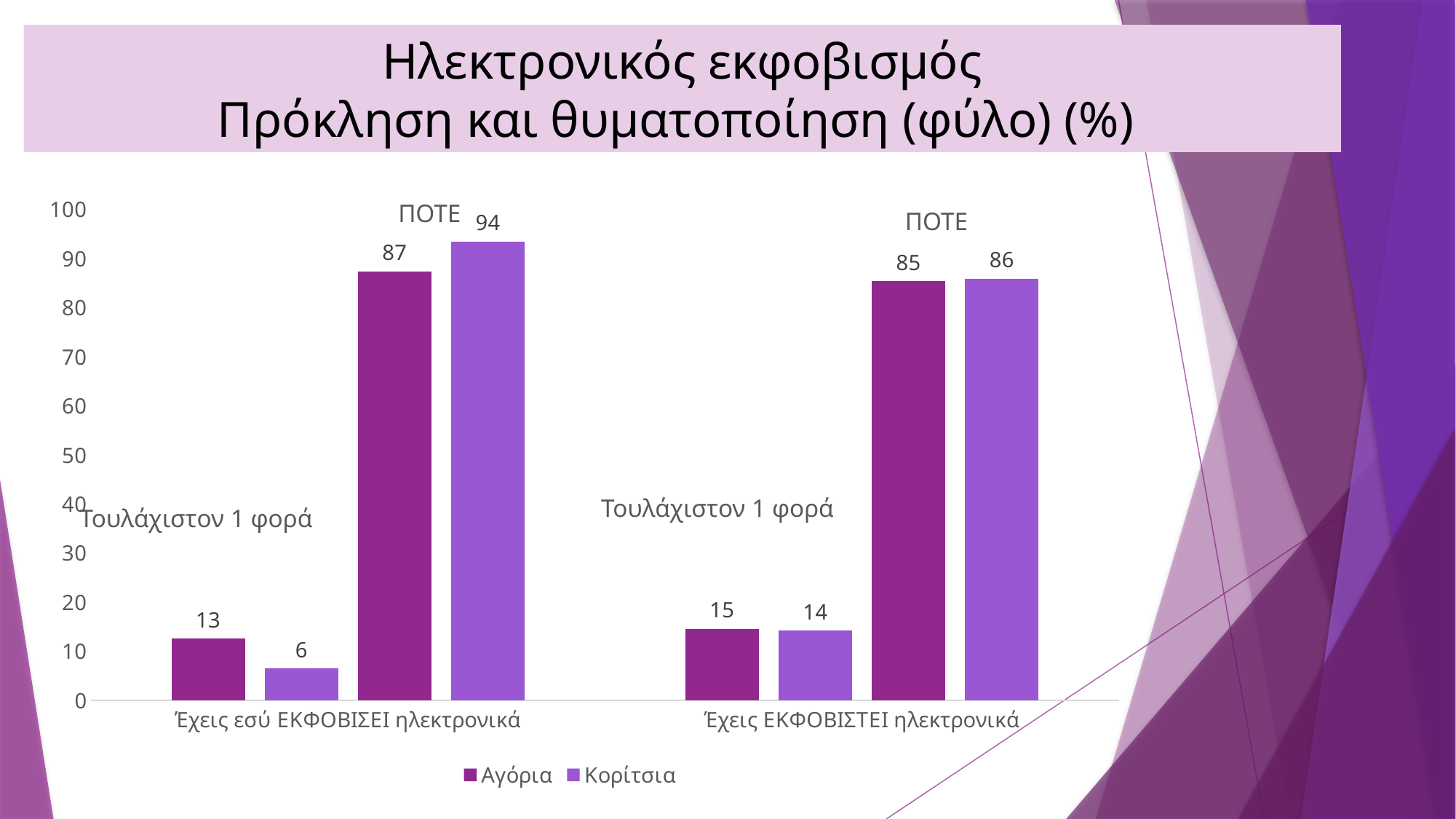
What is the value for Κορίτσια under 'ΠΟΤΕ' in the 'Έχεις εσύ ΕΚΦΟΒΙΣΕΙ ηλεκτρονικά' group? 94 What is the difference between the Κορίτσια 'ΠΟΤΕ' values of the two groups (94 and 86)? 8 Which bar has the lowest value on the chart? Κορίτσια, Τουλάχιστον 1 φορά, Έχεις εσύ ΕΚΦΟΒΙΣΕΙ ηλεκτρονικά (6) What kind of chart is shown on the slide? Bar chart Which bar has the highest value on the chart? Κορίτσια, ΠΟΤΕ, Έχεις εσύ ΕΚΦΟΒΙΣΕΙ ηλεκτρονικά (94) How many series does the legend list? 2 What is the difference between the Αγόρια and Κορίτσια values under 'Τουλάχιστον 1 φορά' in the 'Έχεις εσύ ΕΚΦΟΒΙΣΕΙ ηλεκτρονικά' group? 7 What is the value for Αγόρια under 'Τουλάχιστον 1 φορά' in the 'Έχεις εσύ ΕΚΦΟΒΙΣΕΙ ηλεκτρονικά' group? 13 What are the two series named in the legend? Αγόρια and Κορίτσια In the 'Έχεις εσύ ΕΚΦΟΒΙΣΕΙ ηλεκτρονικά' group under 'ΠΟΤΕ', which is larger, Αγόρια or Κορίτσια? Κορίτσια What is the value for Κορίτσια under 'Τουλάχιστον 1 φορά' in the 'Έχεις ΕΚΦΟΒΙΣΤΕΙ ηλεκτρονικά' group? 14 What is the value for Αγόρια under 'ΠΟΤΕ' in the 'Έχεις ΕΚΦΟΒΙΣΤΕΙ ηλεκτρονικά' group? 85